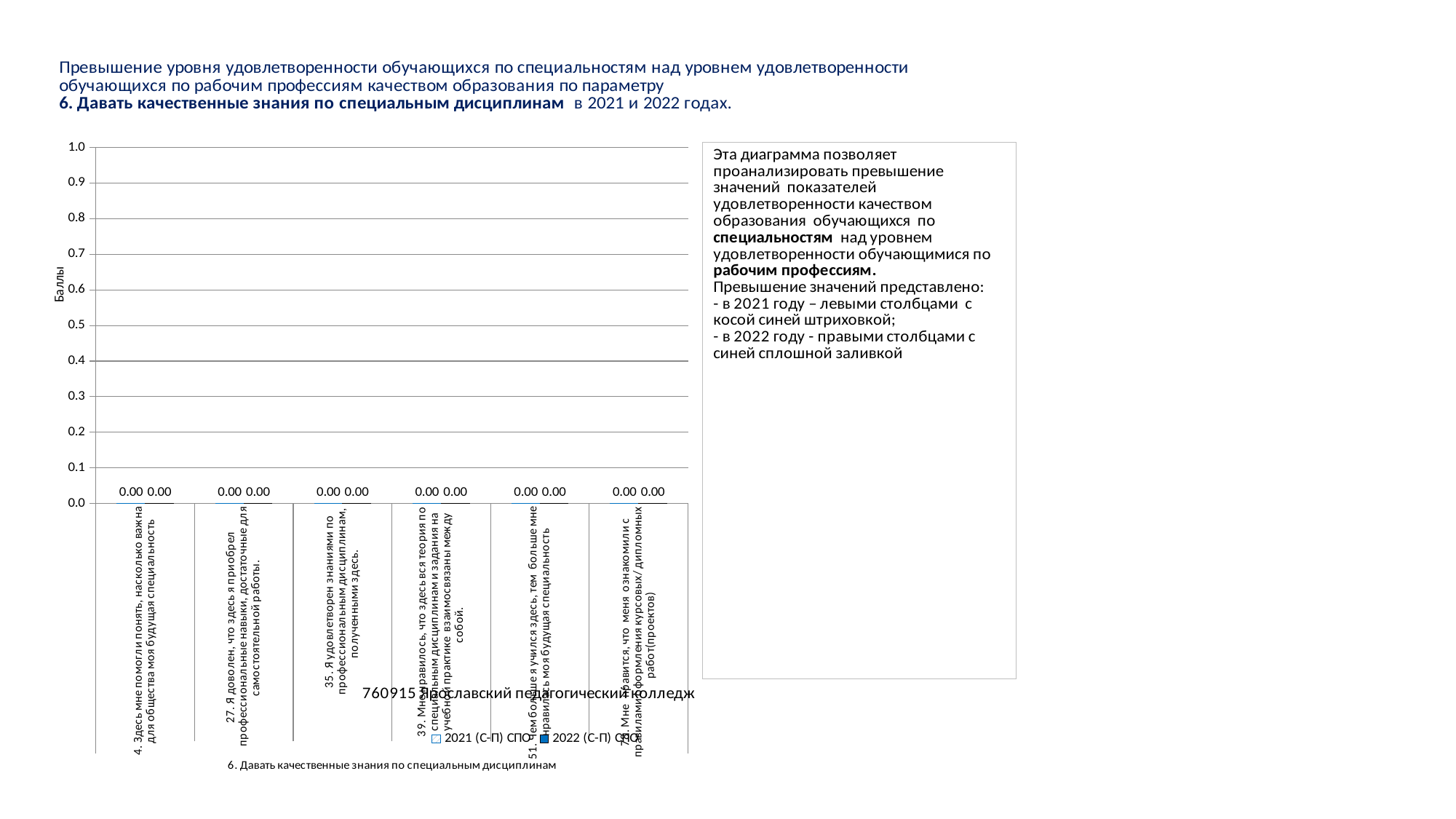
What is the difference between the 2021 (С-П) СПО and 2022 (С-П) СПО values for category 39? 0.00 How many categories are plotted along the x axis? 6 What kind of chart is shown on the slide? bar chart What are the two legend entries of the chart? 2021 (С-П) СПО and 2022 (С-П) СПО What is the value of the 2021 (С-П) СПО series for category 35 ("Я удовлетворен знаниями по профессиональным дисциплинам, полученными здесь")? 0.00 Is the value of the 2022 (С-П) СПО series for category 4 greater or less than 0.1? less How many series does the legend list? 2 What is the value of the 2021 (С-П) СПО series for category 4 ("Здесь мне помогли понять, насколько важна для общества моя будущая специальность")? 0.00 What is the value of the 2022 (С-П) СПО series for category 51 ("Чем больше я учился здесь, тем больше мне нравилась моя будущая специальность")? 0.00 What is the highest tick value shown on the vertical axis? 1.0 What is the value of the 2022 (С-П) СПО series for category 27 ("Я доволен, что здесь я приобрел профессиональные навыки, достаточные для самостоятельной работы")? 0.00 What is the title of the vertical axis? Баллы